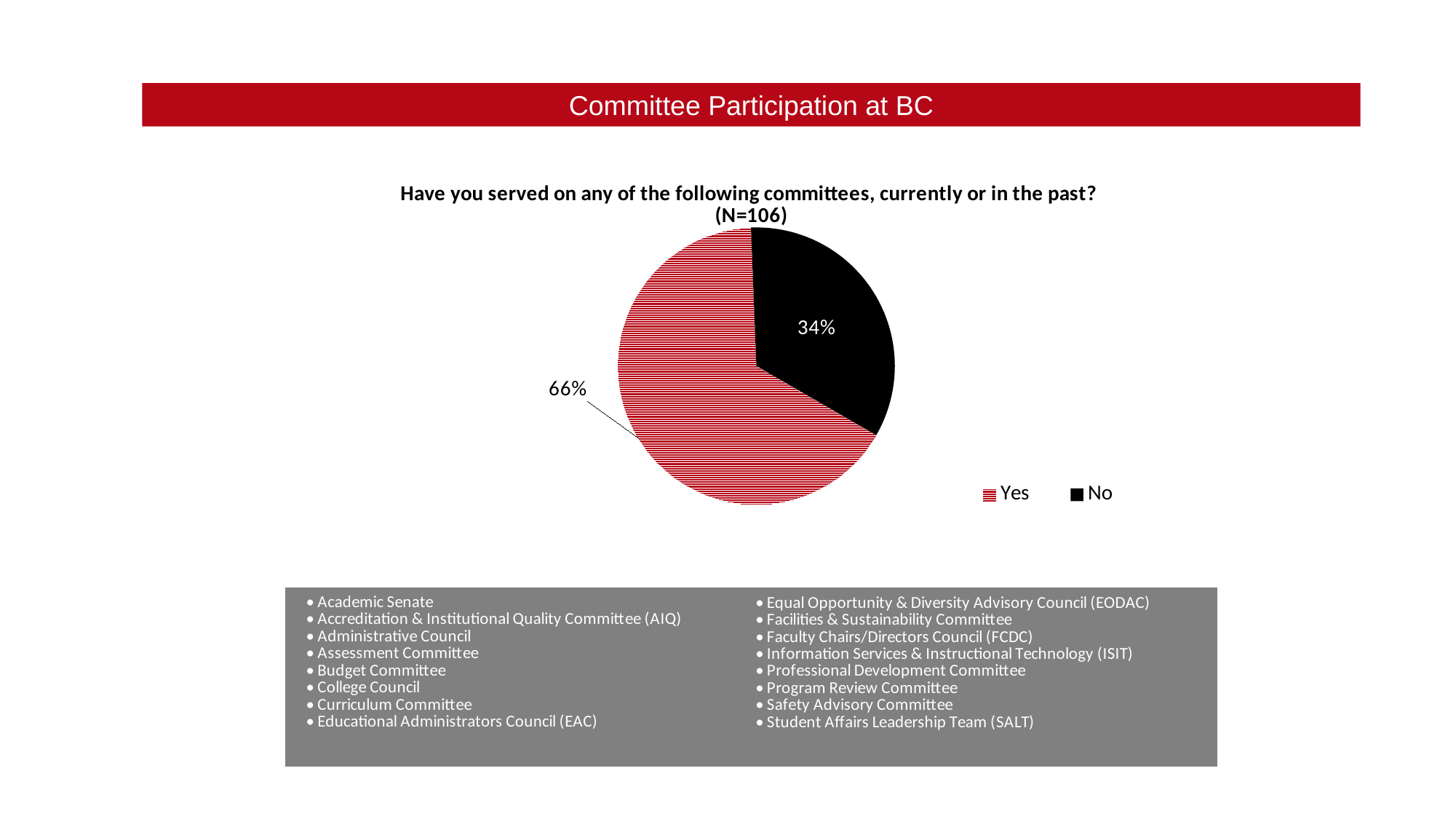
What is the sample size (N) shown in the chart title? 106 Which colour represents the No slice in the pie chart? black What percentage of respondents answered No? 34% Which response has the larger share of the pie? Yes How many slices does the pie chart have? 2 How many entries does the legend list? 2 What is the difference in percentage points between the Yes and No shares? 32 What percentage of respondents answered Yes? 66% Which response has the smaller share of the pie? No Is the share for No greater or less than 50%? less Is the share for Yes larger or smaller than the share for No? larger What type of chart is shown on the slide? pie chart